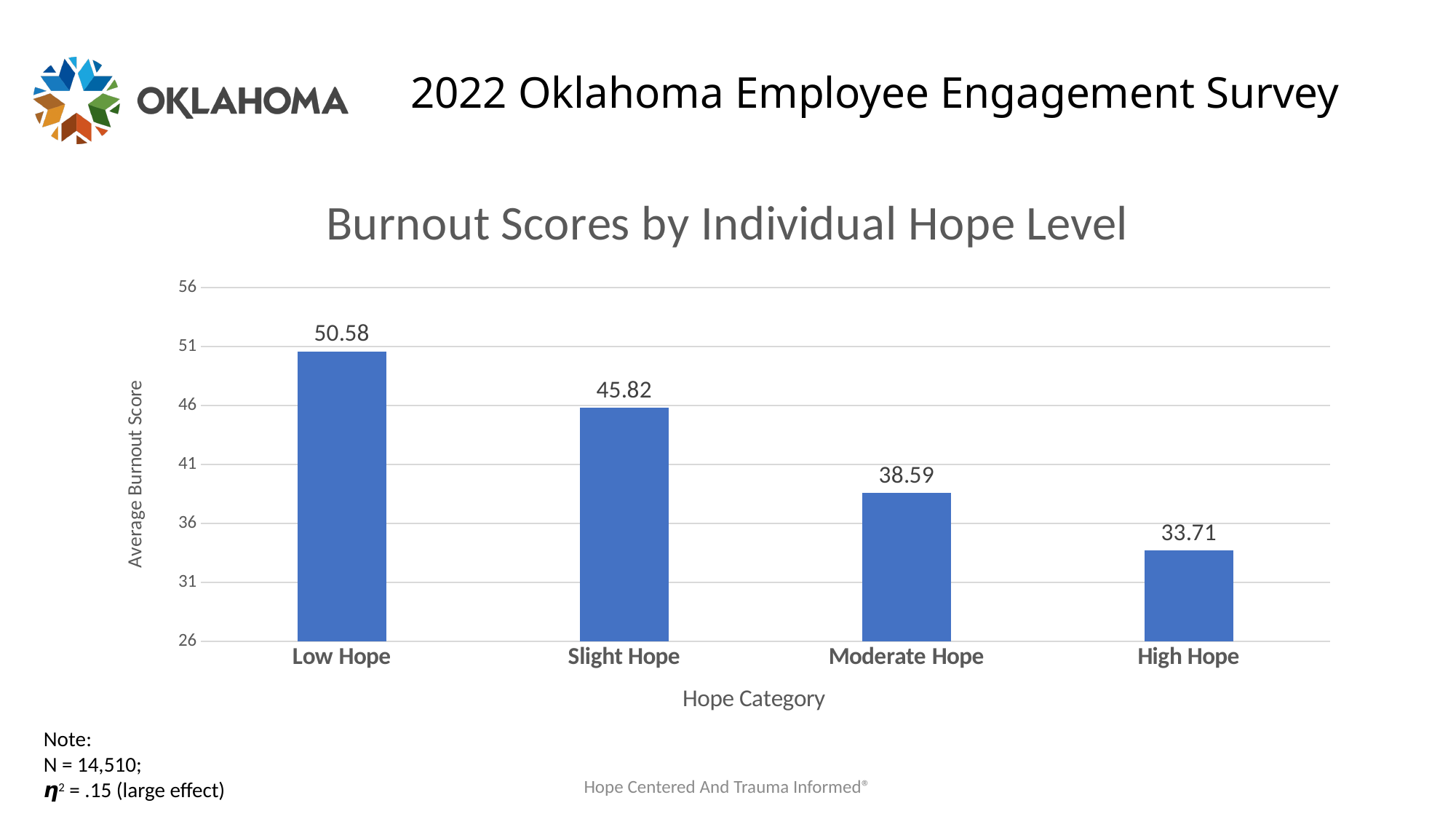
What is the average burnout score for Moderate Hope? 38.59 How many hope categories are shown on the chart? 4 What is the difference between the burnout scores for Low Hope and High Hope? 16.87 What kind of chart is shown on the slide? bar chart What is the average burnout score for Low Hope? 50.58 What is the average burnout score for Slight Hope? 45.82 Which has a higher burnout score, Slight Hope or Moderate Hope? Slight Hope Is the burnout score for Moderate Hope greater or less than 41? less Do the burnout scores rise or fall as hope level increases from Low Hope to High Hope? fall What is the average burnout score for High Hope? 33.71 Which hope category has the highest average burnout score? Low Hope Which hope category has the lowest average burnout score? High Hope